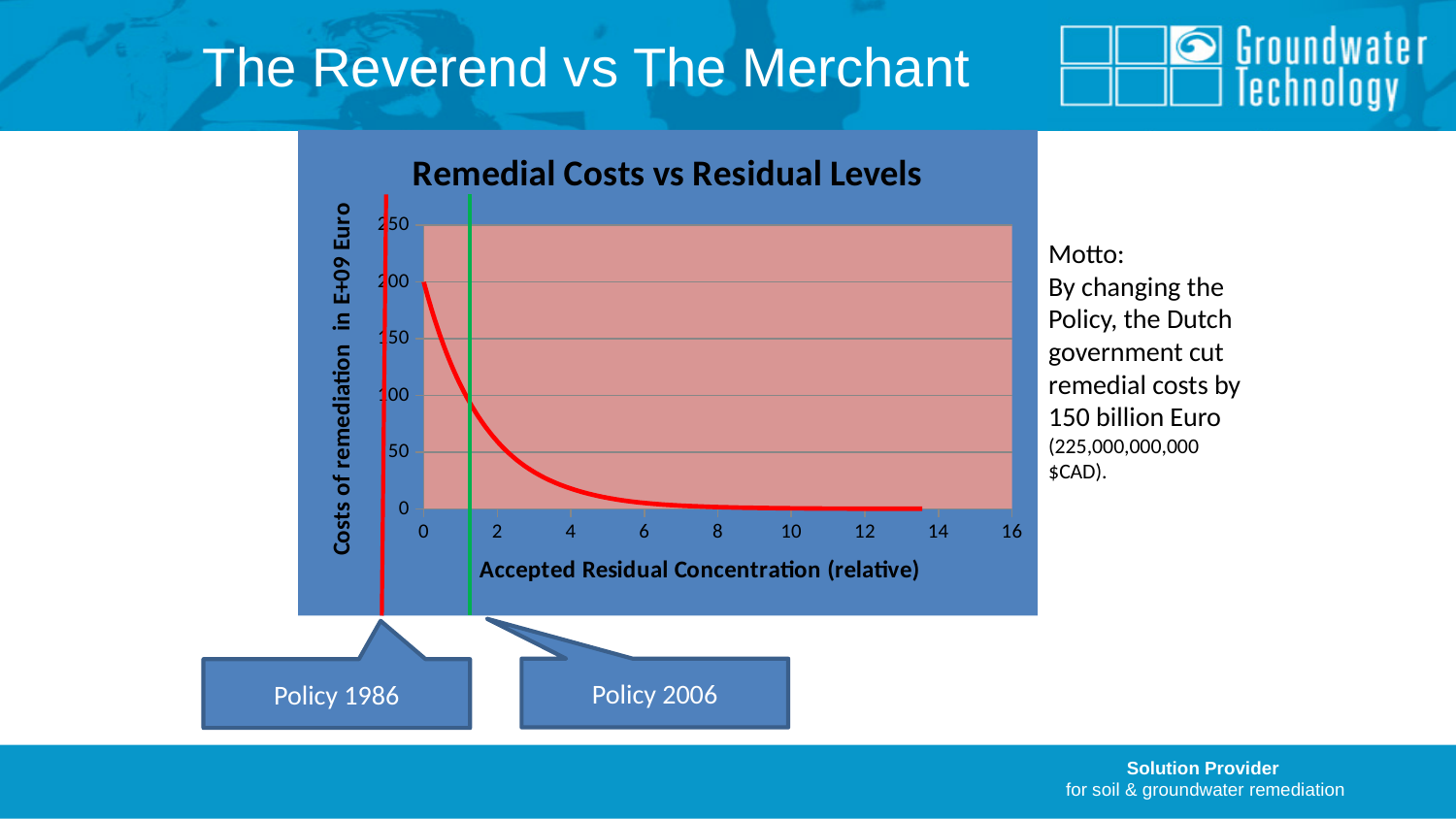
Is the cost of remediation higher at an accepted residual concentration of 2 or of 10? 2 Is the cost of remediation at an accepted residual concentration of 0 greater or less than 150? greater At which accepted residual concentration is the cost of remediation highest? 0 What is the highest value shown on the y axis of the chart? 250 Is the cost of remediation at an accepted residual concentration of 8 greater or less than 50? less What kind of chart is shown on the slide? line chart Do the plotted costs rise or fall as the accepted residual concentration increases along the x axis? fall What is the cost of remediation at an accepted residual concentration of 0? 200 What is the title of the chart? Remedial Costs vs Residual Levels What is the label of the chart's x axis? Accepted Residual Concentration (relative) Is the cost of remediation at an accepted residual concentration of 2 greater or less than 100? less